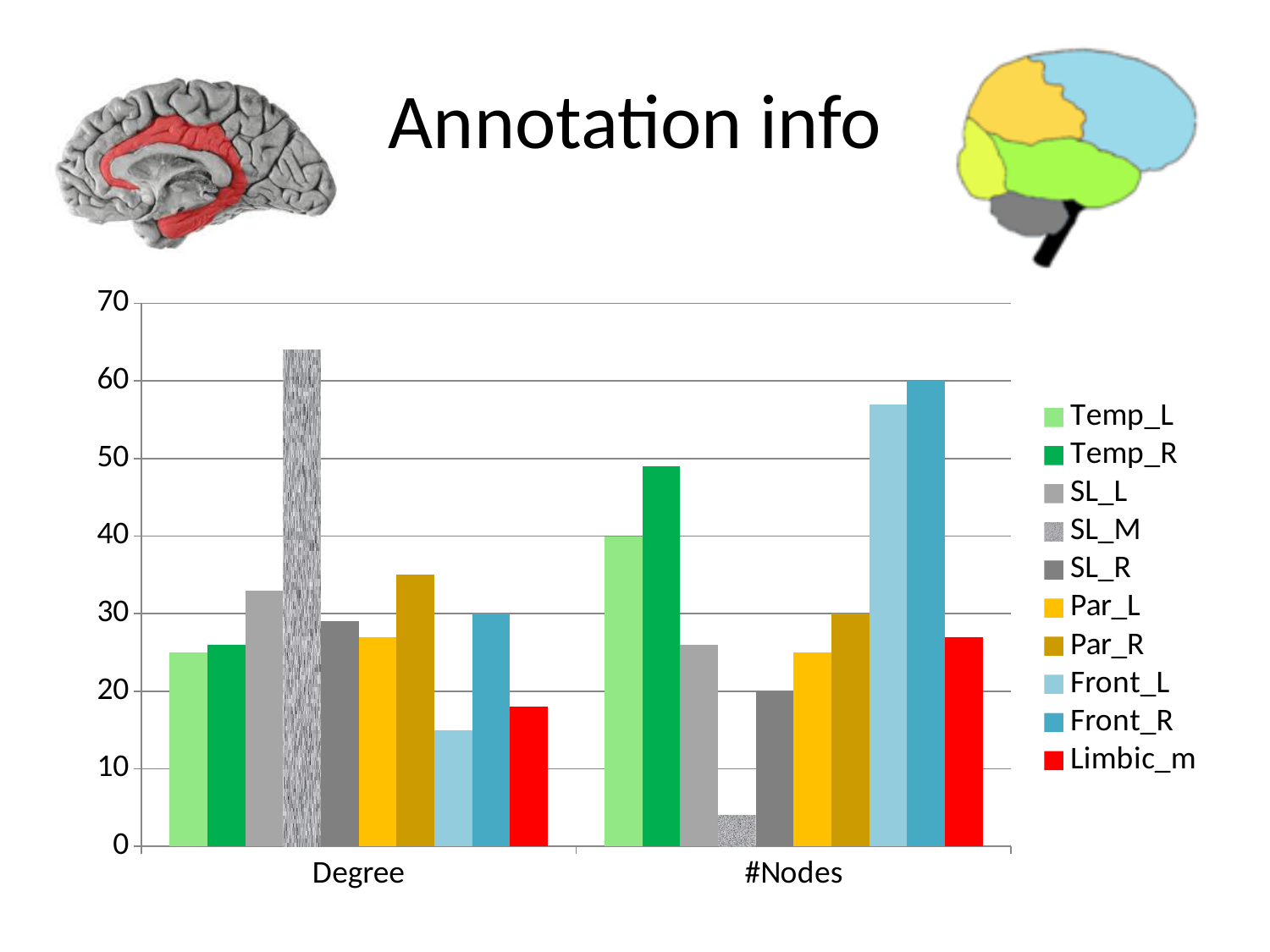
What kind of chart is shown on the slide? bar chart How many categories are shown on the x axis? 2 Is the value for SL_M in the #Nodes category greater or less than 10? less In the #Nodes category, which is larger, Temp_L or Temp_R? Temp_R Which series has the highest value in the Degree category? SL_M What is the value for Temp_L in the #Nodes category? 40 Is the value for SL_M in the Degree category greater or less than 60? greater What is the value for Front_R in the #Nodes category? 60 Which series has the lowest value in the #Nodes category? SL_M Is the value for Front_L in the #Nodes category greater or less than 50? greater Which series has the highest value in the #Nodes category? Front_R How many series does the legend list? 10